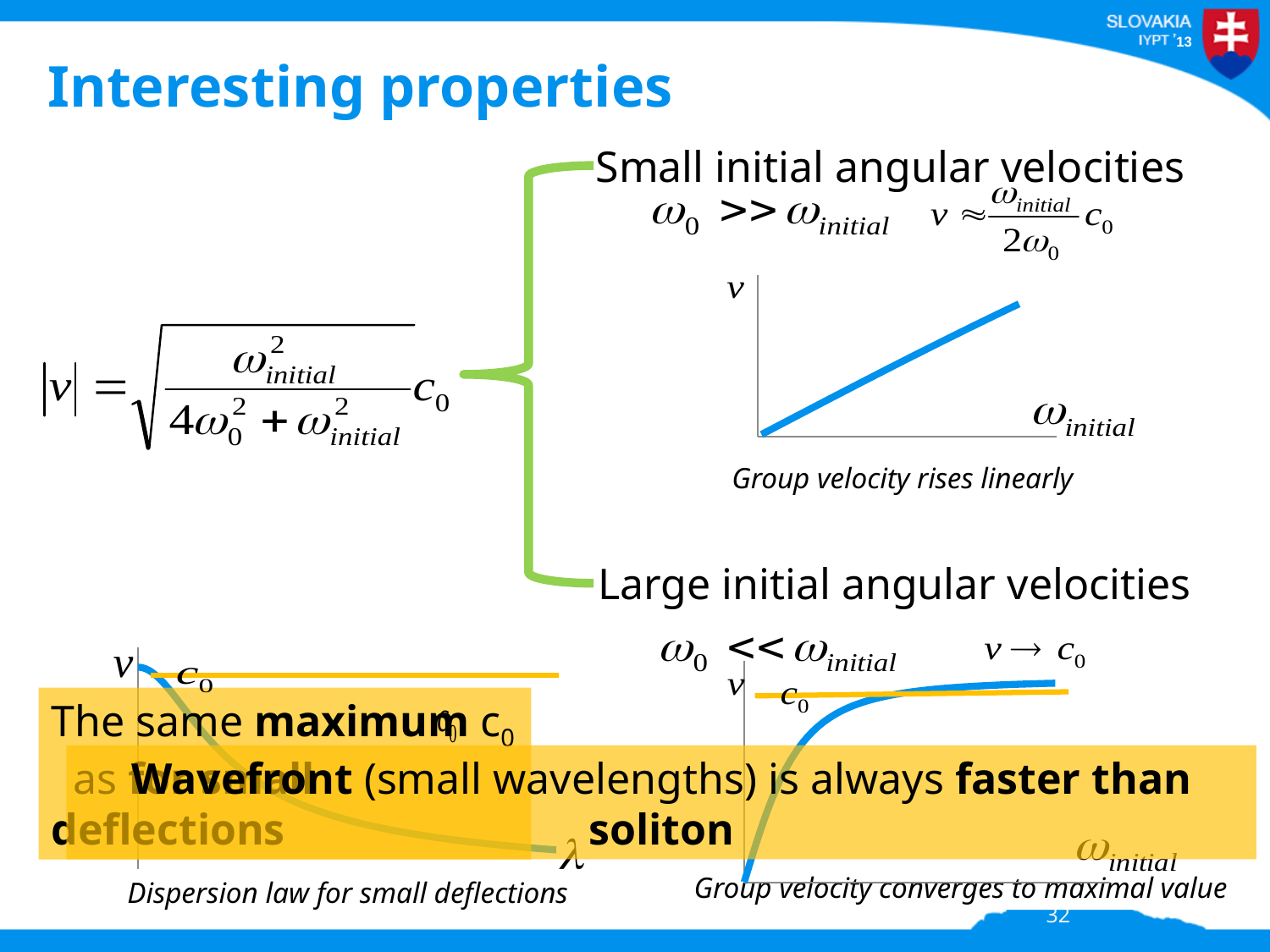
How many charts are shown on the slide? 3 In the chart captioned 'Group velocity rises linearly', what is the label on the horizontal axis? ω_initial In the chart captioned 'Group velocity rises linearly', does v rise or fall as ω_initial increases? rise In the chart captioned 'Dispersion law for small deflections', does v rise or fall as λ increases? fall In the chart captioned 'Group velocity rises linearly', what is the label on the vertical axis? v In the chart captioned 'Group velocity converges to maximal value', what value does the horizontal line mark? c0 In the chart captioned 'Group velocity converges to maximal value', what kind of chart is shown? line chart In the chart captioned 'Group velocity converges to maximal value', does v rise or fall as ω_initial increases? rise In the chart captioned 'Group velocity rises linearly', what kind of chart is shown? line chart